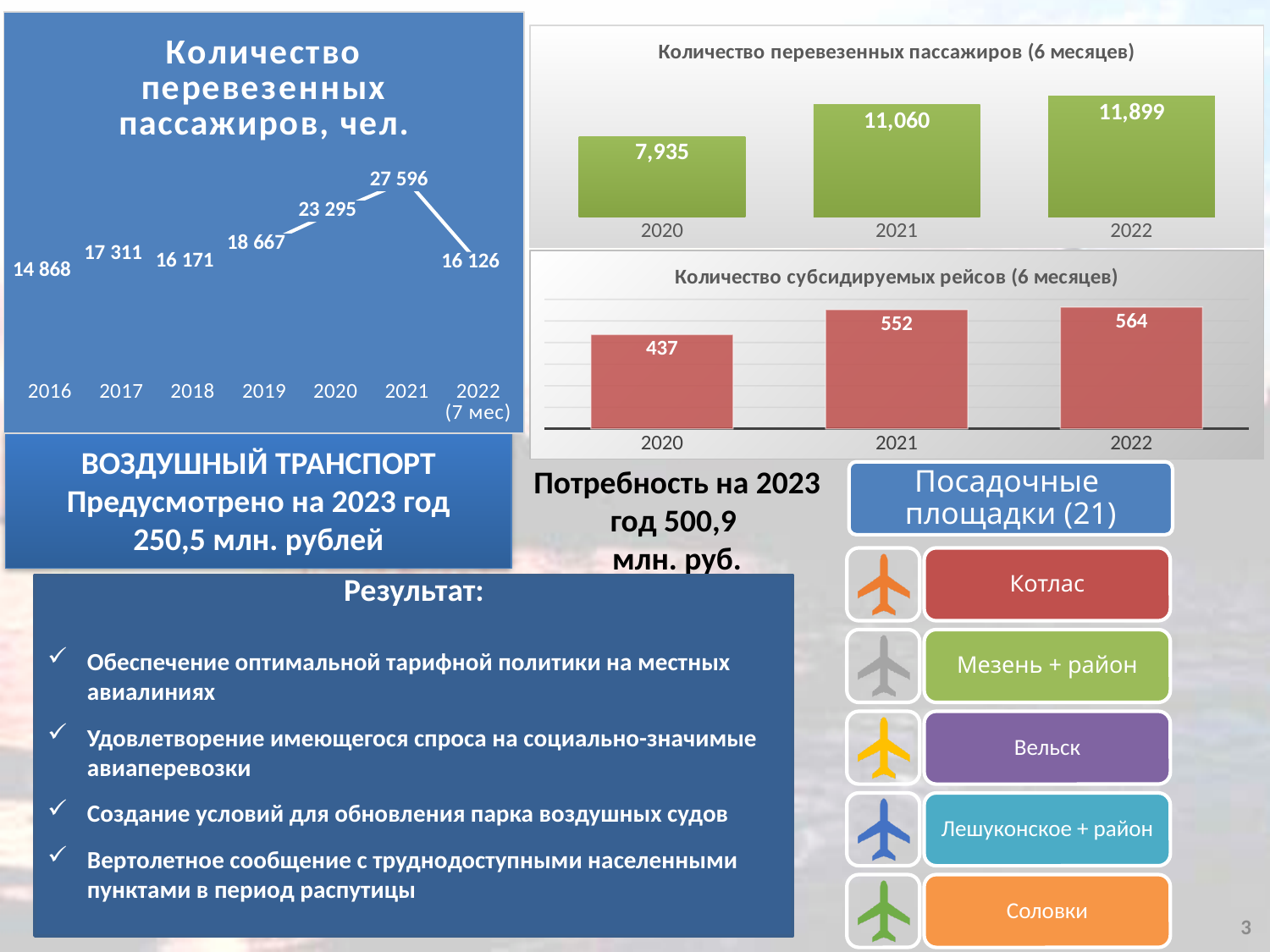
In the chart 'Количество перевезенных пассажиров, чел.', how many data points are plotted? 7 In the chart 'Количество перевезенных пассажиров, чел.', what is the value for 2022 (7 мес)? 16 126 In the chart 'Количество субсидируемых рейсов (6 месяцев)', do the values rise or fall from 2020 to 2022? rise In the chart 'Количество перевезенных пассажиров, чел.', what is the value for 2021? 27 596 In the chart 'Количество перевезенных пассажиров (6 месяцев)', which year has the highest value? 2022 In the chart 'Количество перевезенных пассажиров (6 месяцев)', what is the value for 2020? 7,935 What kind of chart is 'Количество субсидируемых рейсов (6 месяцев)'? bar chart In the chart 'Количество перевезенных пассажиров (6 месяцев)', what is the difference between the 2022 and 2021 values? 839 In the chart 'Количество перевезенных пассажиров, чел.', what is the difference between the 2021 and 2020 values? 4 301 In the chart 'Количество перевезенных пассажиров, чел.', which year has the lowest value? 2016 In the chart 'Количество субсидируемых рейсов (6 месяцев)', what is the value for 2021? 552 In the chart 'Количество субсидируемых рейсов (6 месяцев)', which is larger, the value for 2020 or the value for 2022? 2022